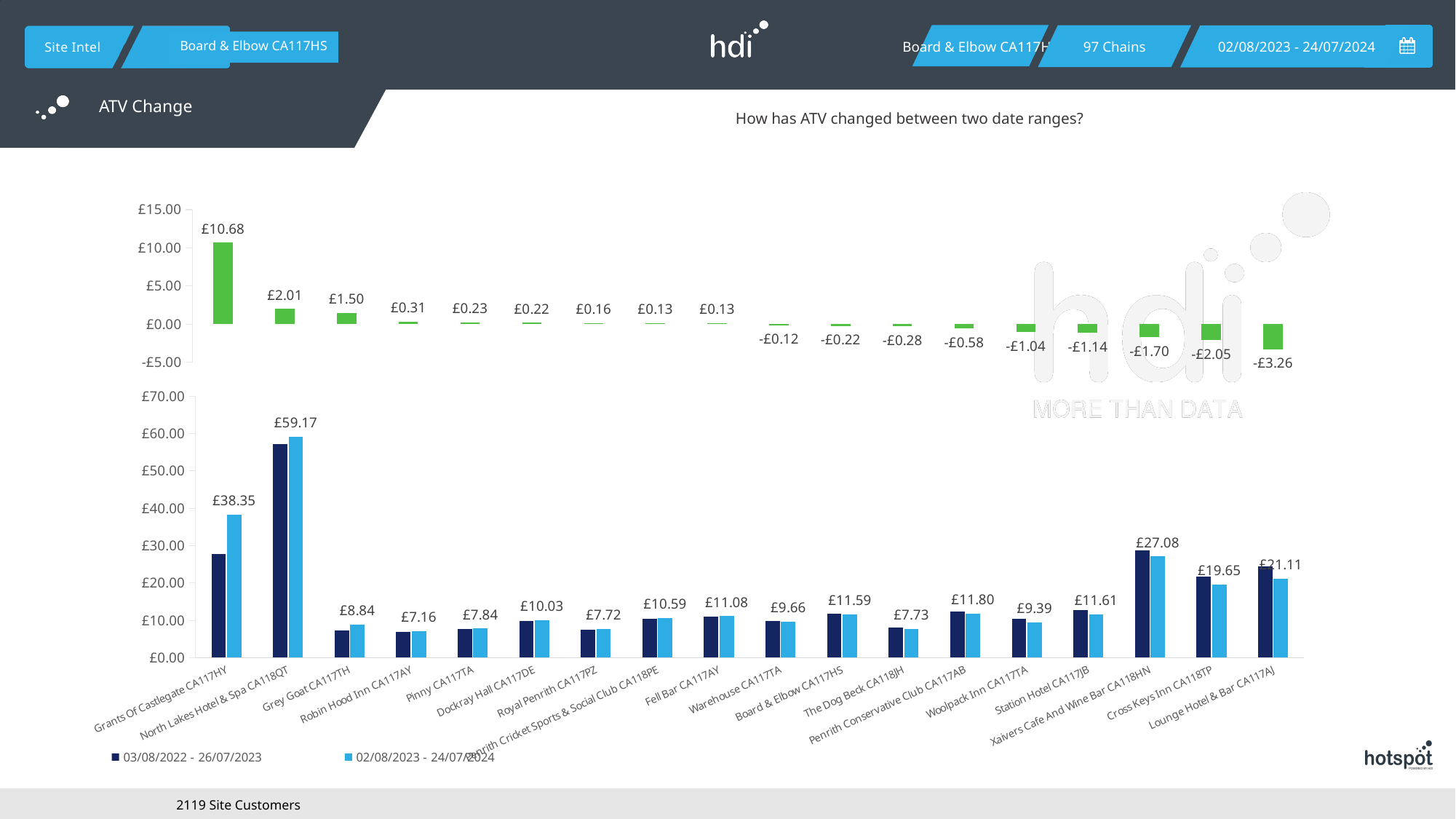
In the bottom chart, is the 03/08/2022 - 26/07/2023 value for Grants Of Castlegate CA117HY greater or less than £30.00? less In the top chart, which site has the highest ATV change? Grants Of Castlegate CA117HY In the top chart, what is the ATV change shown for Grants Of Castlegate CA117HY? £10.68 In the top chart, which site has the lowest ATV change? Lounge Hotel & Bar CA117AJ In the top chart, what is the ATV change shown for Cross Keys Inn CA118TP? -£2.05 What kind of chart is the bottom chart? Bar chart In the bottom chart, which site has the highest ATV in the 02/08/2023 - 24/07/2024 period? North Lakes Hotel & Spa CA118QT How many sites are shown along the x axis of the bottom chart? 18 In the top chart, what is the difference between the ATV change for Grants Of Castlegate CA117HY and North Lakes Hotel & Spa CA118QT? £8.67 In the bottom chart, what is the labelled value for North Lakes Hotel & Spa CA118QT in the 02/08/2023 - 24/07/2024 period? £59.17 In the bottom chart, how many series does the legend list? 2 In the bottom chart, which has the larger labelled value for 02/08/2023 - 24/07/2024: Xaivers Cafe And Wine Bar CA118HN or Lounge Hotel & Bar CA117AJ? Xaivers Cafe And Wine Bar CA118HN